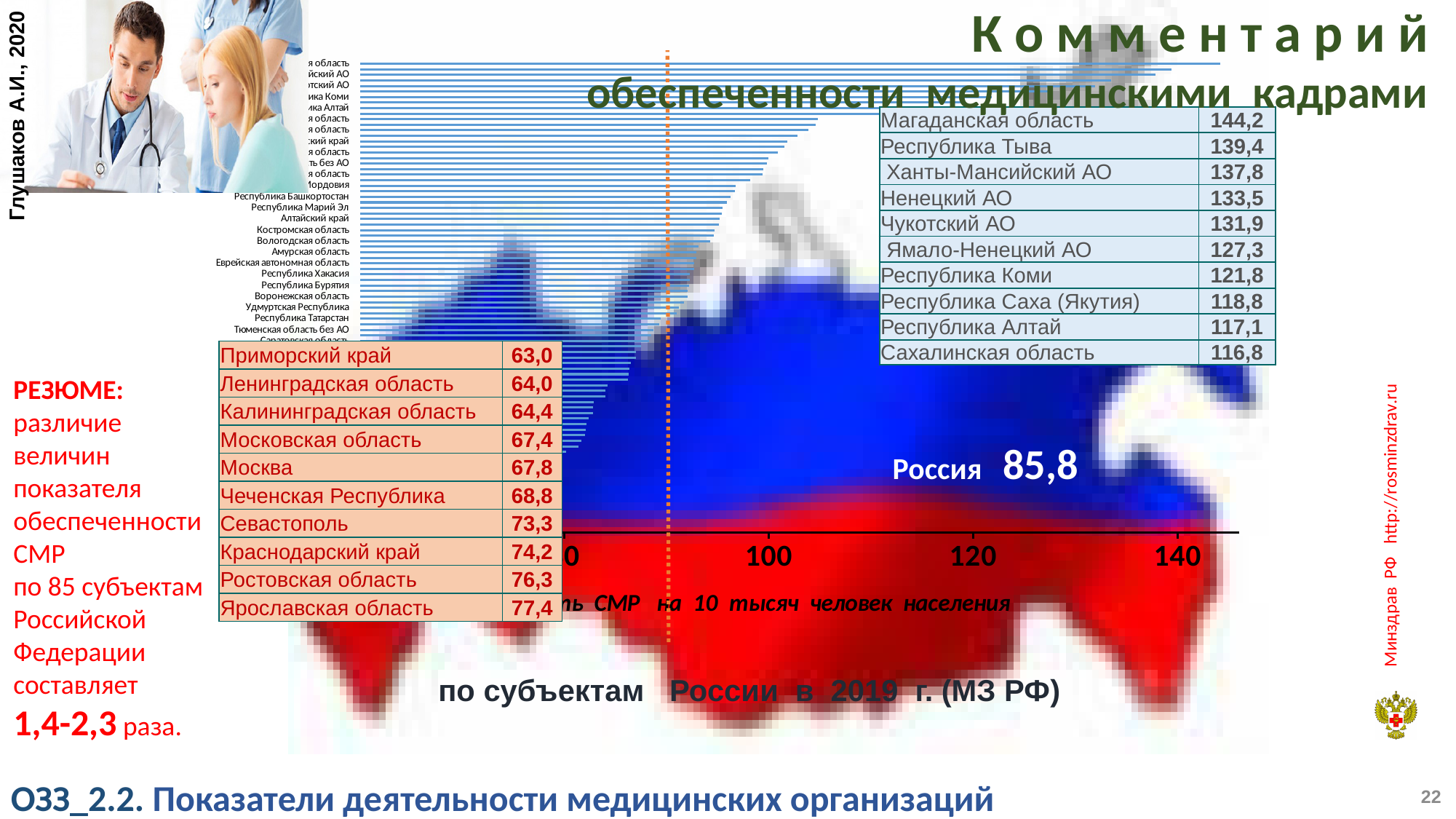
Which is larger, the value for Севастополь or for Краснодарский край? Краснодарский край What is the value for Магаданская область? 144,2 How many regions are listed in the table of highest values (top right)? 10 Is the value for Сахалинская область greater or less than 120? less What is the value for Приморский край? 63,0 What is the difference between the values for Магаданская область and Приморский край? 81,2 What is the value shown for Россия as a whole? 85,8 What kind of chart is shown on the slide? bar chart Which region has the lowest value? Приморский край Which region has the highest value? Магаданская область What is the value for Москва? 67,8 What is the difference between the values for Магаданская область and Республика Тыва? 4,8